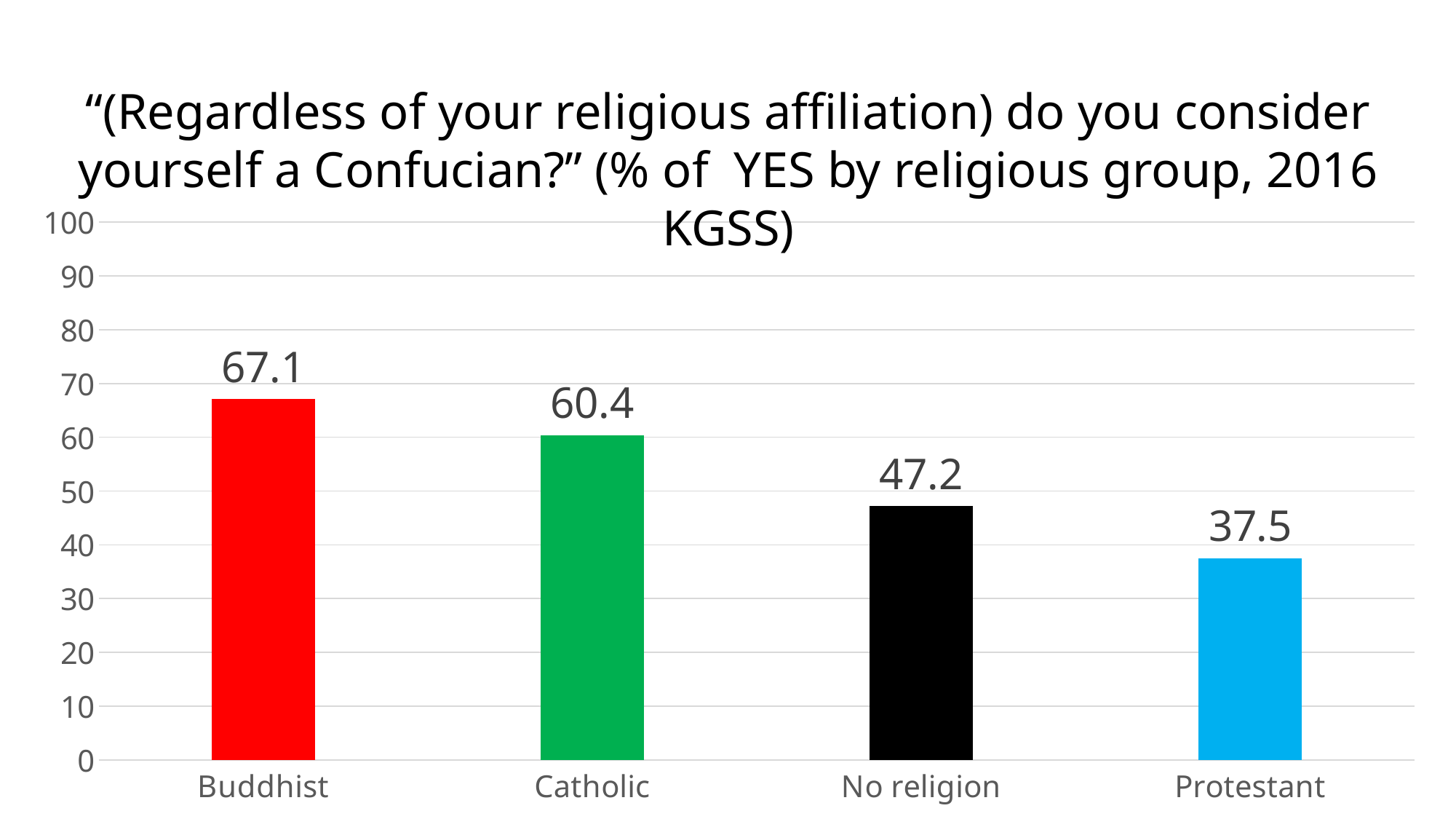
What kind of chart is shown on the slide? Bar chart What is the value shown for Catholic? 60.4 What is the difference between the Catholic and No religion values? 13.2 Which religious group has the lowest percentage of YES responses? Protestant What is the value shown for Protestant? 37.5 Which religious group has the highest percentage of YES responses? Buddhist Which is larger, the value for Catholic or the value for No religion? Catholic What is the difference between the Buddhist and Protestant values? 29.6 What is the value shown for No religion? 47.2 How many religious groups are shown on the chart? 4 What percentage of Buddhists answered YES to considering themselves Confucian? 67.1 What colour is the bar for No religion? Black